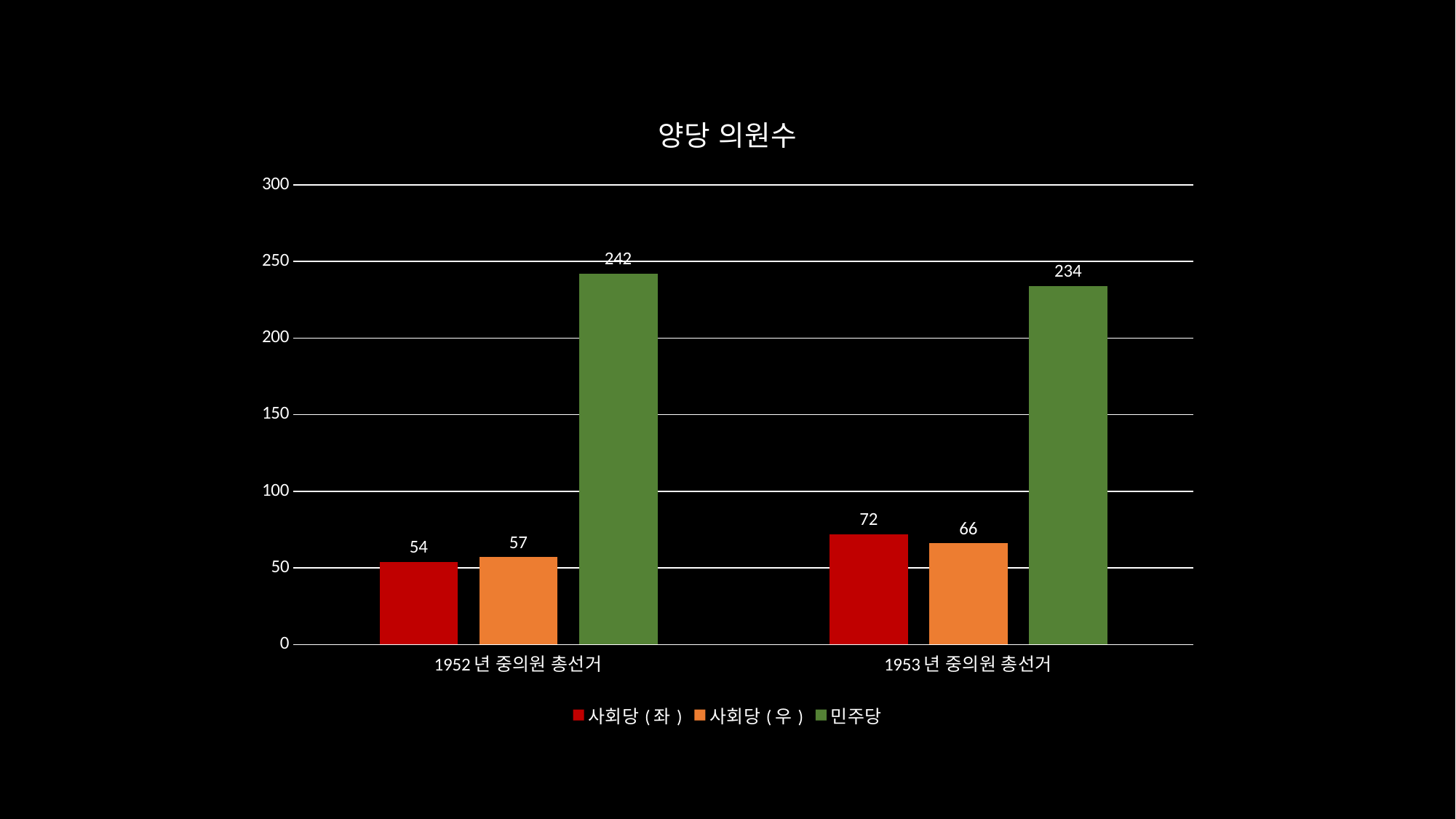
Does the value for 사회당 ( 우 ) rise or fall from 1952 년 중의원 총선거 to 1953 년 중의원 총선거? Rise What is the title of the chart? 양당 의원수 Which series has the highest value in 1953 년 중의원 총선거? 민주당 Which is larger: 사회당 ( 좌 ) in 1953 년 중의원 총선거 or 사회당 ( 우 ) in 1953 년 중의원 총선거? 사회당 ( 좌 ) What is the value for 사회당 ( 좌 ) in 1953 년 중의원 총선거? 72 What kind of chart is shown? Bar chart How many series does the legend list? 3 How many categories are shown on the x axis? 2 What is the value for 민주당 in 1952 년 중의원 총선거? 242 What is the difference between the 민주당 values for 1952 년 중의원 총선거 and 1953 년 중의원 총선거? 8 What is the value for 사회당 ( 우 ) in 1952 년 중의원 총선거? 57 Which series has the lowest value in 1952 년 중의원 총선거? 사회당 ( 좌 )